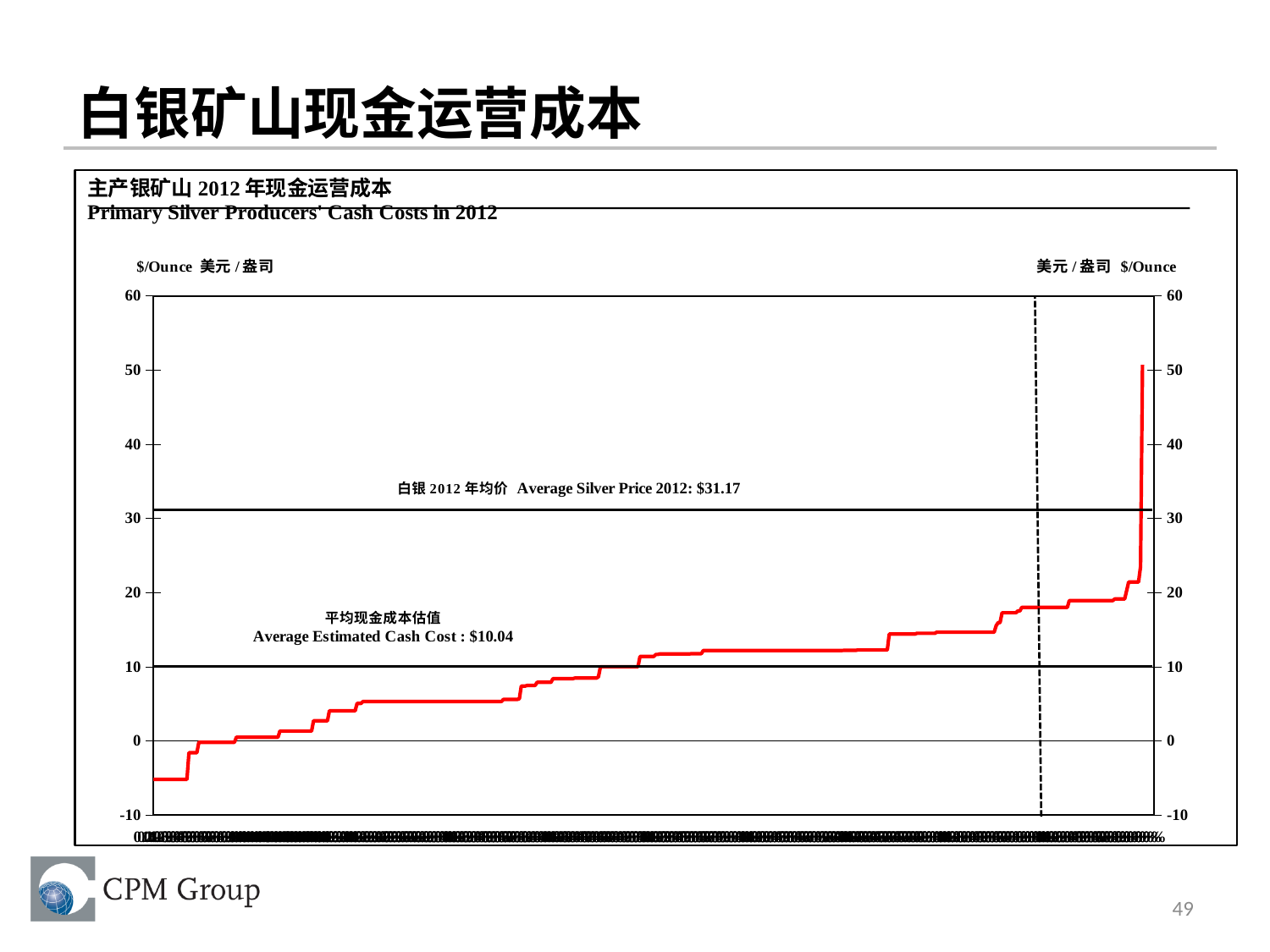
What kind of chart is shown on the slide? line chart What is the English title of the chart? Primary Silver Producers' Cash Costs in 2012 What is the difference between the average silver price 2012 and the average estimated cash cost shown on the chart? $21.13 What average silver price for 2012 is printed on the chart? $31.17 What average estimated cash cost is printed on the chart? $10.04 Is the highest point of the red line greater or less than 40? greater Is the lowest point of the red line greater or less than 0? less What is the maximum value shown on the vertical axis? 60 Do the cash cost values rise or fall from left to right along the x axis? rise What unit is shown on the vertical axis of the chart? $/Ounce What is the minimum value shown on the vertical axis? -10 Which is larger, the average silver price 2012 or the average estimated cash cost? Average Silver Price 2012